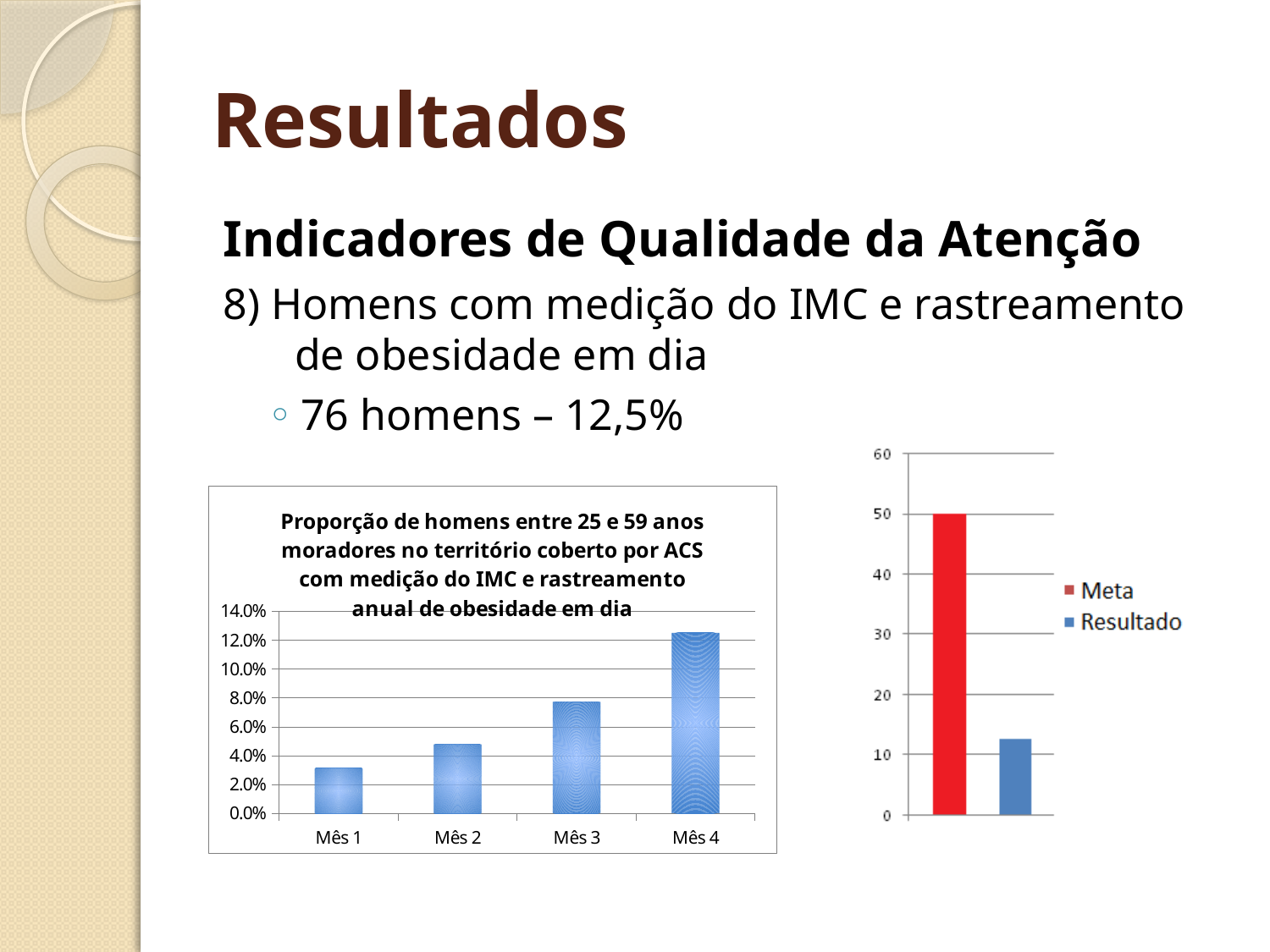
What kind of chart is the left chart titled 'Proporção de homens entre 25 e 59 anos...'? bar chart In the left chart, is the value for Mês 2 greater or less than 6.0%? less In the right chart, what is the value of Meta? 50 In the left chart, is the value for Mês 4 greater or less than 12.0%? greater In the right chart, is the value for Resultado greater or less than 20? less In the right chart, how many series does the legend list? 2 In the left chart, do the values rise or fall from Mês 1 to Mês 4? rise In the left chart, how many months (categories) are shown on the x axis? 4 In the left chart, which month has the lowest value? Mês 1 In the left chart, which is larger, the value for Mês 2 or the value for Mês 3? Mês 3 In the left chart, which month has the highest value? Mês 4 In the right chart, which series is shown in red? Meta